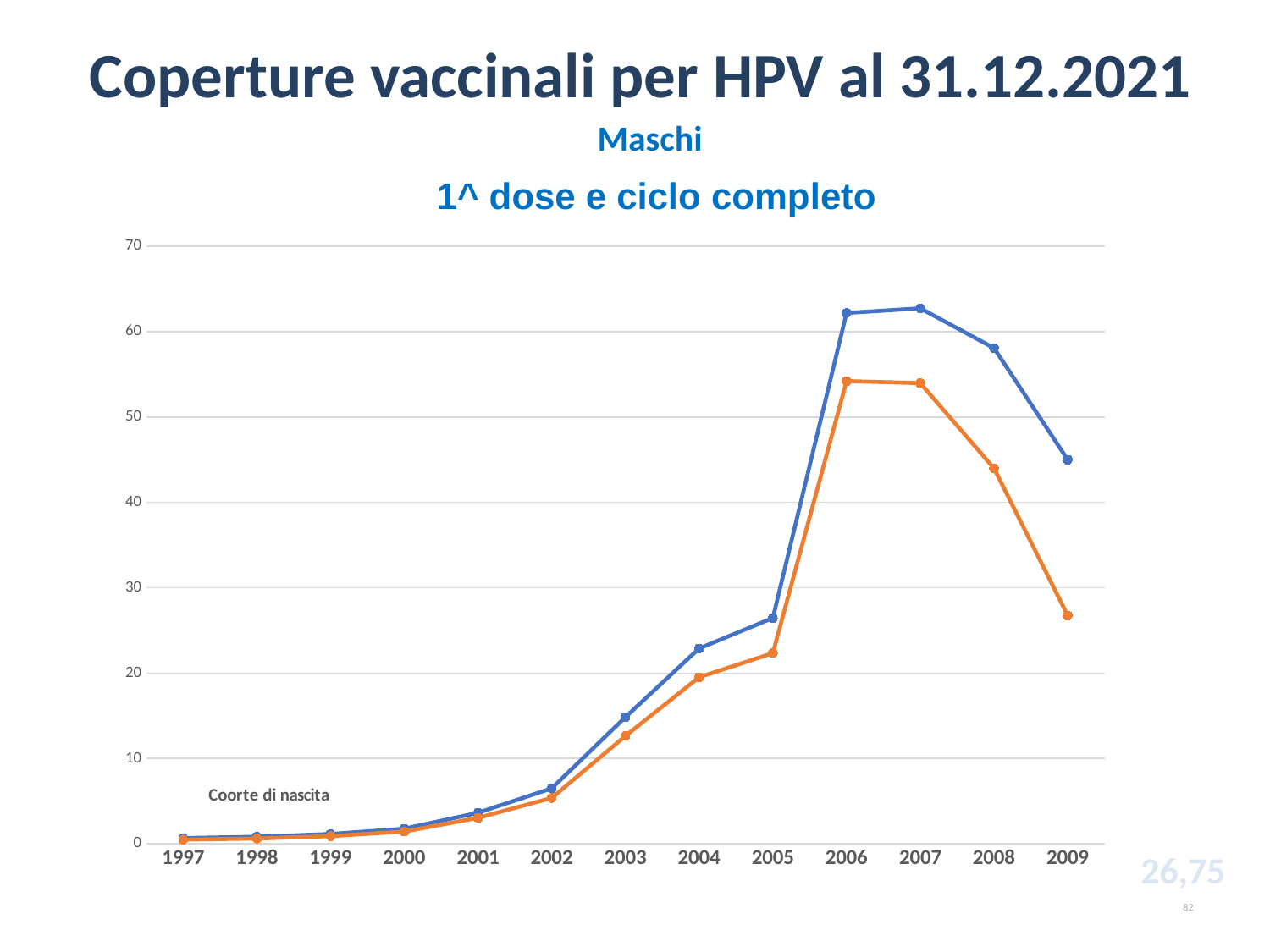
Is the value of the blue line for 2005 greater or less than 30? less For the 2009 cohort, which line has the higher value, the blue line or the orange line? the blue line What kind of chart is shown on the slide? line chart How many birth cohorts (years) are plotted along the x axis? 13 Is the value of the blue line for 2009 greater or less than 40? greater Which birth cohort has the lowest value for the orange line? 1997 Which birth cohort has the lowest value for the blue line? 1997 What label is shown for the x axis of the chart? Coorte di nascita Is the value of the orange line for 2009 greater or less than 30? less Do the values of the orange line rise or fall from 2007 to 2009? fall Do the values of the blue line rise or fall from 1997 to 2007? rise